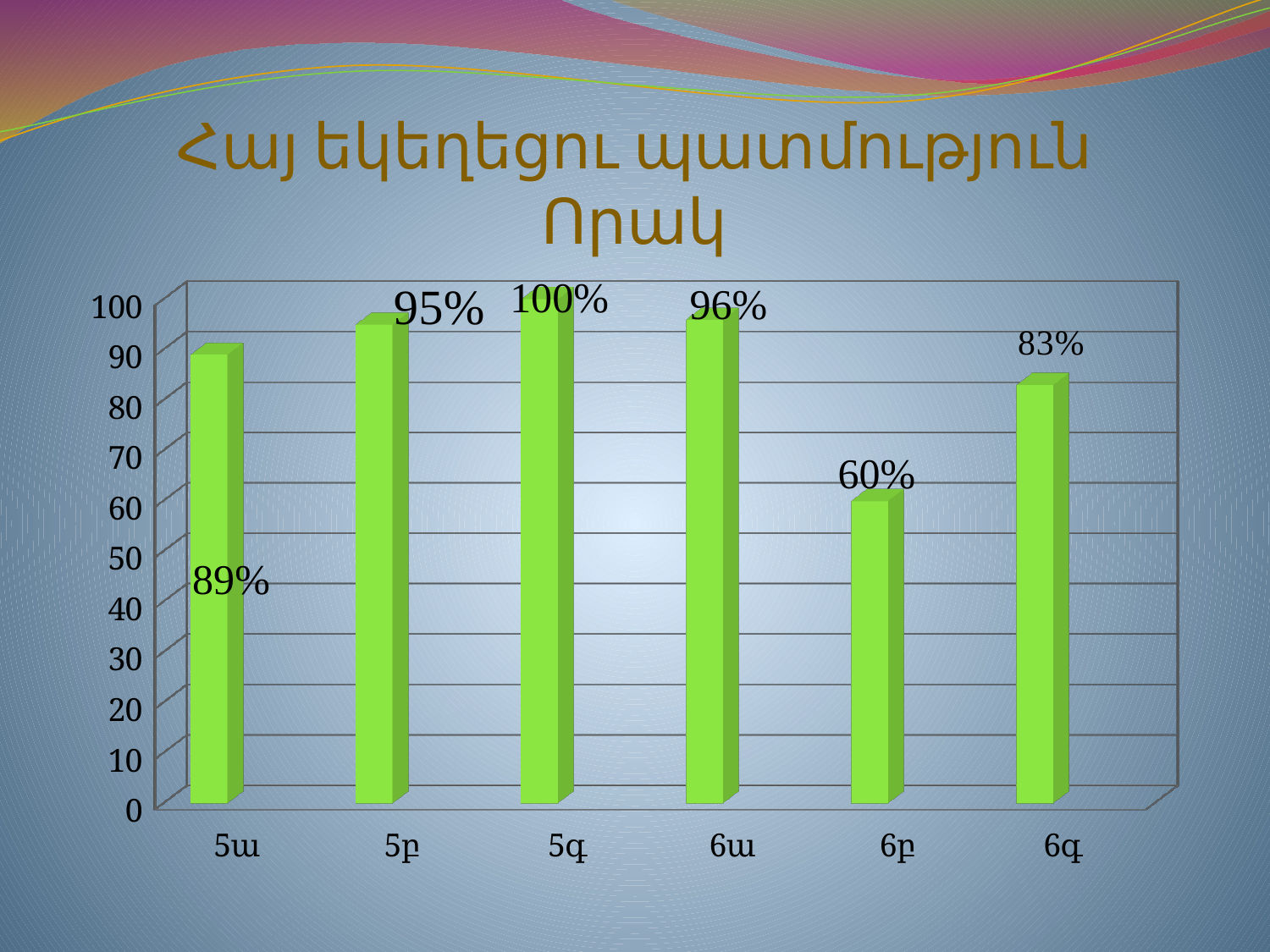
What kind of chart is shown on the slide? bar chart Which category has the lowest value? 6բ What colour are the bars in the chart? green What is the difference between the values for 6ա and 6գ? 13% What is the value for 6բ? 60% Which category has the highest value? 5գ Which is larger, the value for 5բ or the value for 6ա? 6ա What is the difference between the values for 5գ and 6բ? 40% How many categories are shown on the x axis? 6 Is the value for 6բ greater or less than 70? less What is the value for 5ա? 89% What is the value for 6գ? 83%